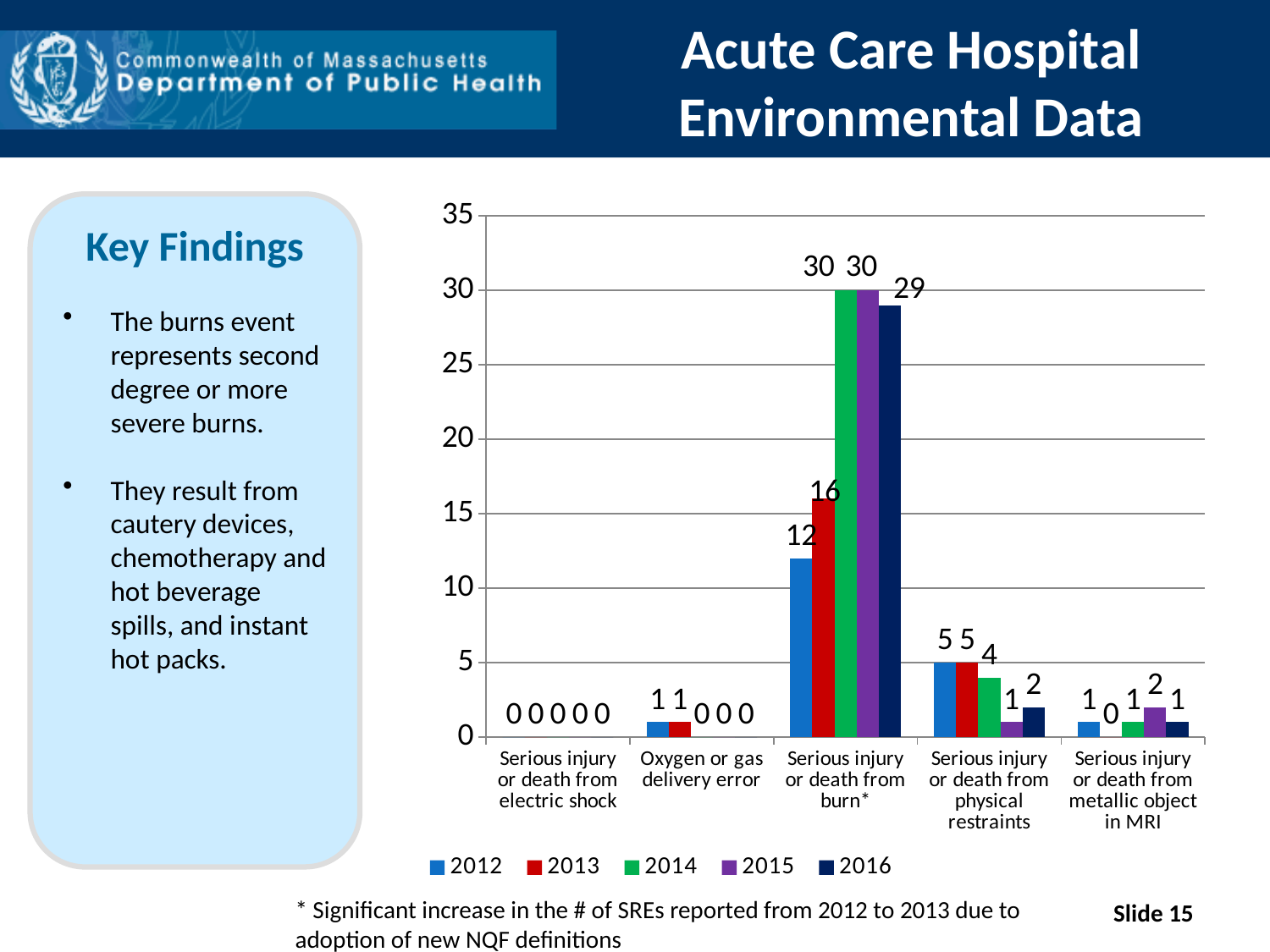
Which year is shown in the legend with a green colour? 2014 What is the value for 2013 in the 'Serious injury or death from metallic object in MRI' category? 0 Is the 2015 value for 'Serious injury or death from burn*' greater or less than 25? greater What is the value for 2013 in the 'Serious injury or death from burn*' category? 16 What is the value for 2015 in the 'Serious injury or death from physical restraints' category? 1 What is the value for 2016 in the 'Serious injury or death from burn*' category? 29 What is the difference between the 2014 and 2012 values for 'Serious injury or death from burn*'? 18 Which is larger in the 'Serious injury or death from physical restraints' category: the 2012 value or the 2016 value? 2012 How many series does the legend list? 5 What kind of chart is shown on the slide? bar chart Which category has the highest value for 2014? Serious injury or death from burn* How many categories are shown on the x axis? 5